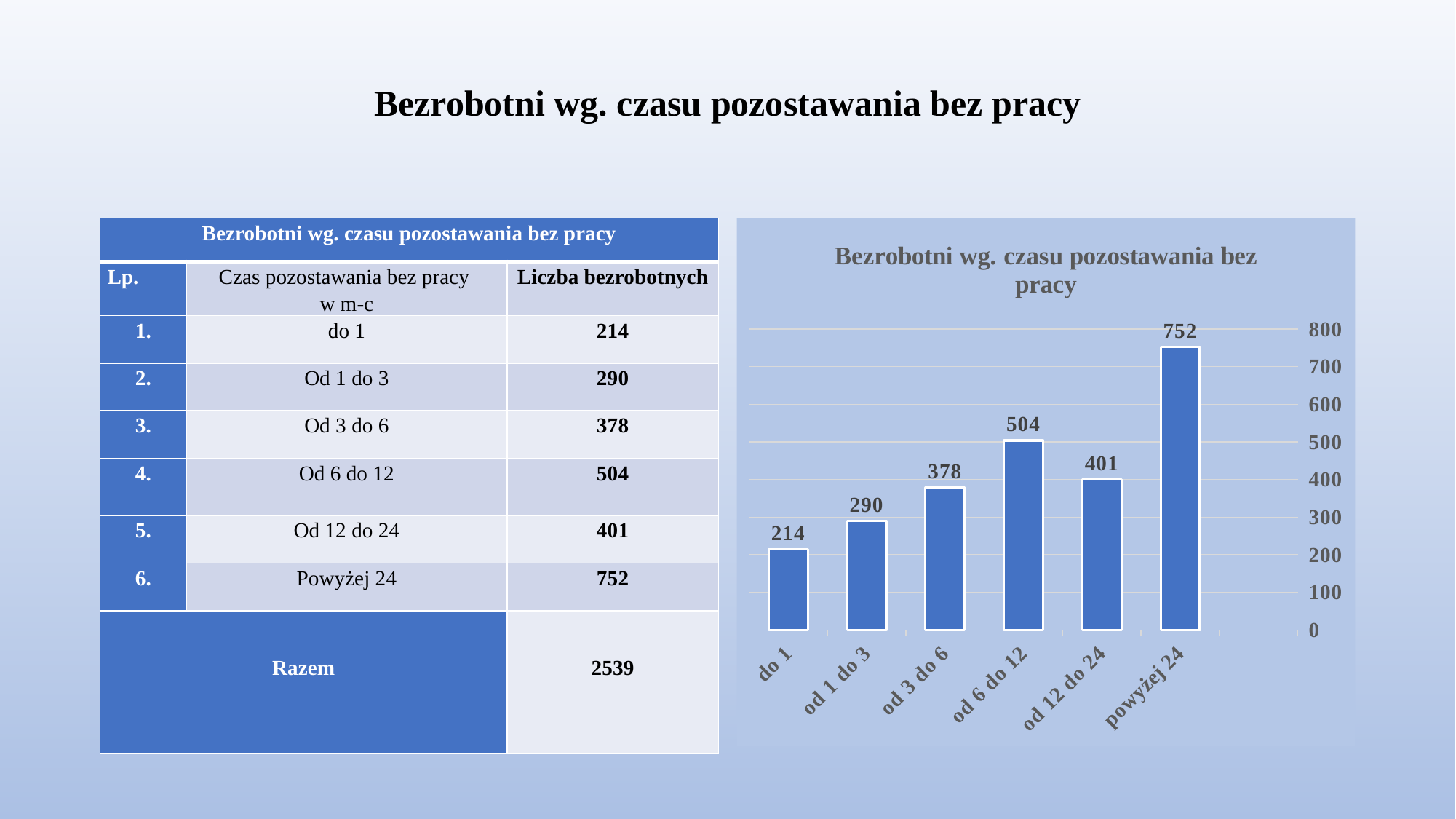
How many categories are shown on the x axis of the chart? 6 What is the value for the 'powyżej 24' category in the chart? 752 Is the value for 'od 6 do 12' greater or less than 400? greater What is the difference between the values for 'powyżej 24' and 'do 1'? 538 Which category has the highest value in the chart? powyżej 24 What is the value for the 'od 12 do 24' category in the chart? 401 Which category has the lowest value in the chart? do 1 What is the title of the chart? Bezrobotni wg. czasu pozostawania bez pracy What kind of chart is shown on the slide? bar chart What is the difference between the values for 'od 6 do 12' and 'od 12 do 24'? 103 Which is larger, the value for 'od 1 do 3' or the value for 'od 3 do 6'? od 3 do 6 What is the value for the 'od 3 do 6' category in the chart? 378